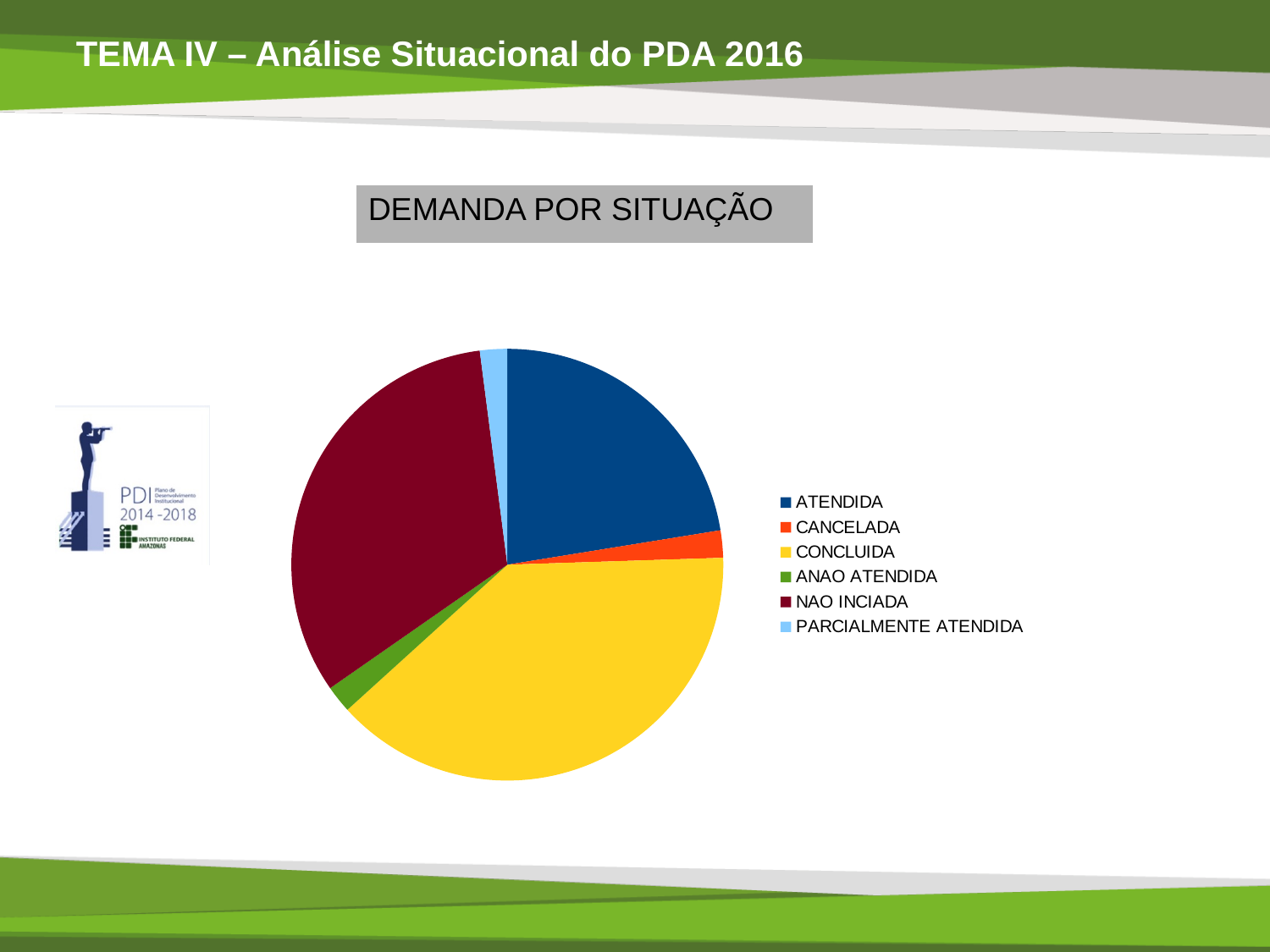
How many entries does the legend list? 6 What kind of chart is shown on the slide? pie chart How many categories does the pie chart show? 6 Which slice is larger, NAO INCIADA or ANAO ATENDIDA? NAO INCIADA What is the title of the chart? DEMANDA POR SITUAÇÃO Which colour represents CONCLUIDA in the pie chart? yellow Which slice is larger, ATENDIDA or NAO INCIADA? NAO INCIADA Which slice is larger, CONCLUIDA or ATENDIDA? CONCLUIDA Which category has the largest slice of the pie? CONCLUIDA